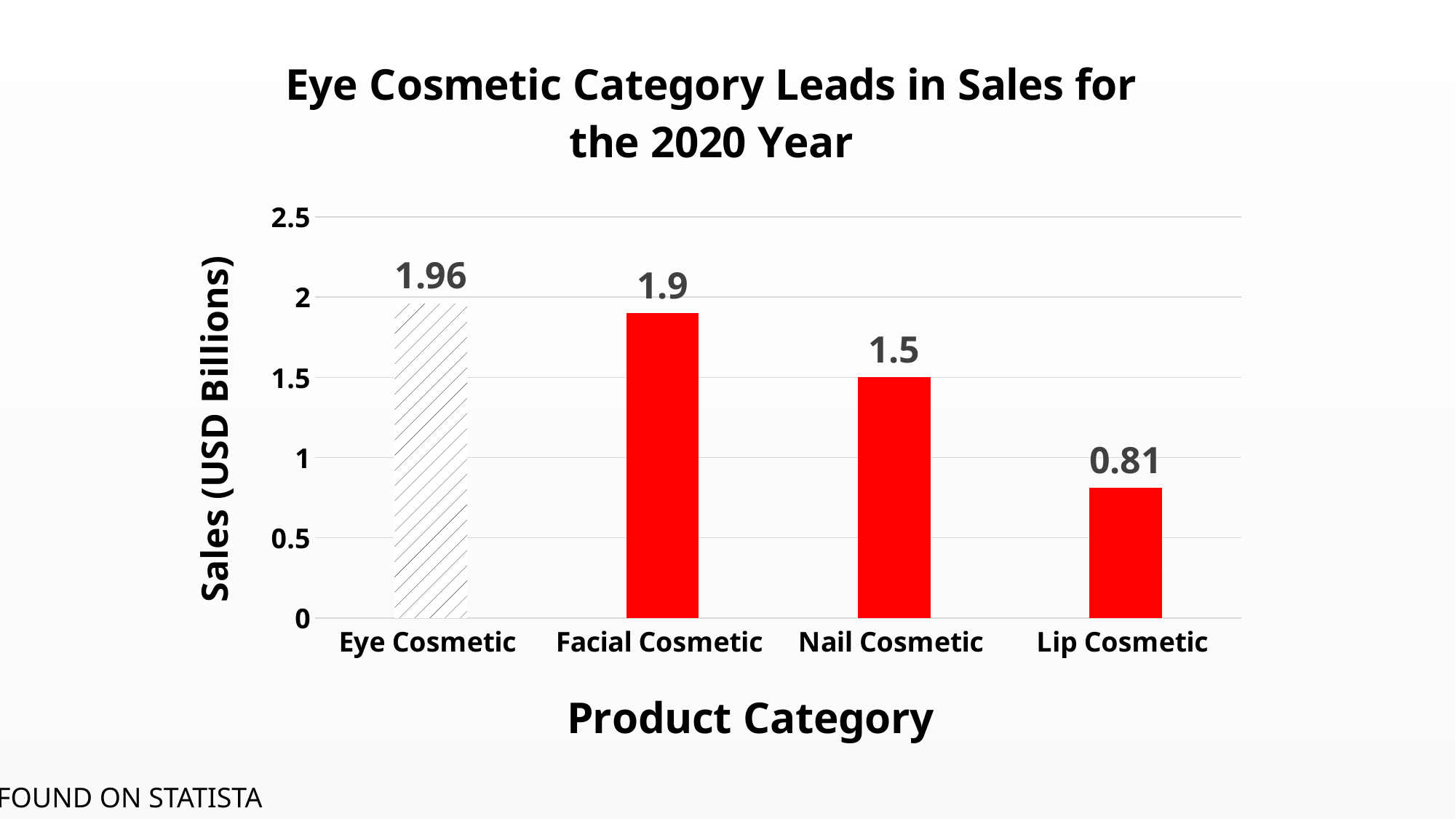
How many product categories are shown in the chart? 4 What is the difference in sales between Eye Cosmetic and Lip Cosmetic? 1.15 Which product category has the highest sales? Eye Cosmetic What is the sales value for Nail Cosmetic? 1.5 What kind of chart is shown on the slide? Bar chart Which product category has the lowest sales? Lip Cosmetic What is the difference in sales between Facial Cosmetic and Nail Cosmetic? 0.4 Do the sales values rise or fall from left to right across the categories? Fall What is the sales value for Eye Cosmetic? 1.96 What is the title of the chart? Eye Cosmetic Category Leads in Sales for the 2020 Year Which has higher sales, Nail Cosmetic or Lip Cosmetic? Nail Cosmetic What is the sales value for Lip Cosmetic? 0.81